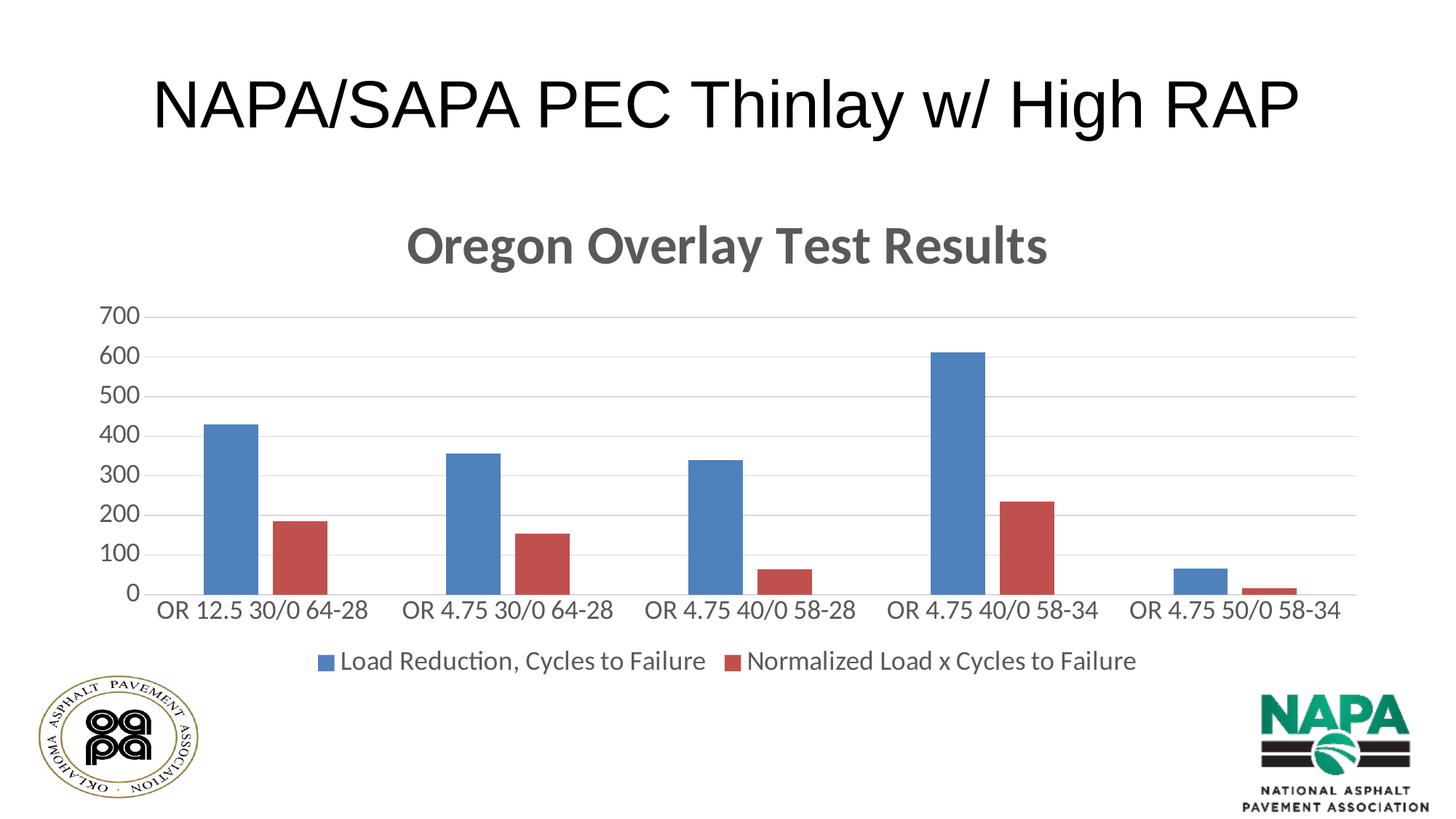
Which category has the lowest Load Reduction, Cycles to Failure value? OR 4.75 50/0 58-34 Is the Normalized Load x Cycles to Failure value for OR 4.75 40/0 58-28 greater or less than 100? less What is the title of the chart? Oregon Overlay Test Results Which category has the highest Normalized Load x Cycles to Failure value? OR 4.75 40/0 58-34 Which has the larger Load Reduction, Cycles to Failure value: OR 12.5 30/0 64-28 or OR 4.75 30/0 64-28? OR 12.5 30/0 64-28 Is the Load Reduction, Cycles to Failure value for OR 12.5 30/0 64-28 greater or less than 400? greater Which colour represents the Load Reduction, Cycles to Failure series? blue What kind of chart is shown on the slide? bar chart Which category has the highest Load Reduction, Cycles to Failure value? OR 4.75 40/0 58-34 How many mix categories are shown along the x axis? 5 Is the Load Reduction, Cycles to Failure value for OR 4.75 40/0 58-34 greater or less than 500? greater How many series does the legend list? 2